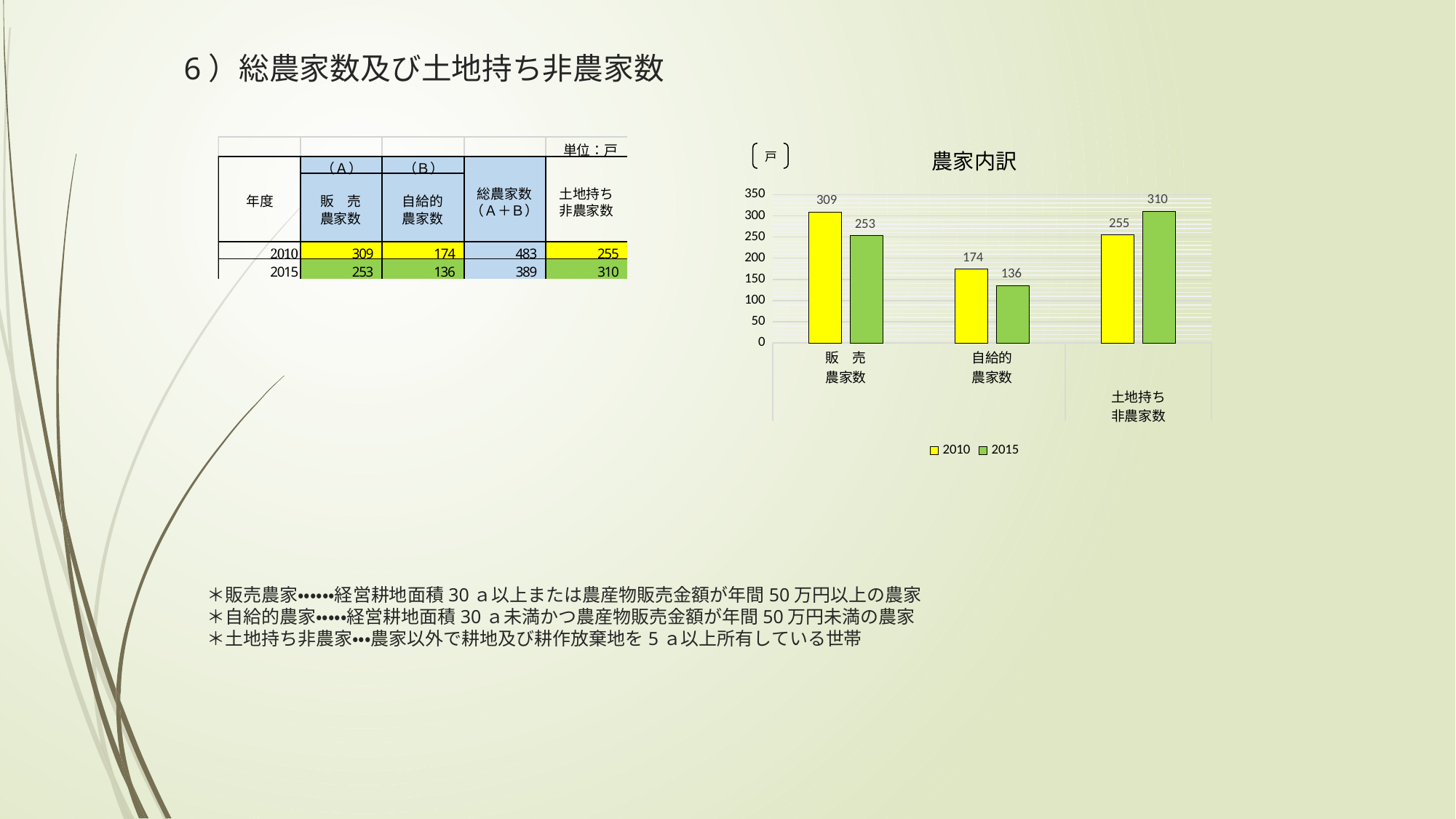
What is the title of the chart on the slide? 農家内訳 Which category has the lowest 2015 value in the 農家内訳 chart? 自給的農家数 How many series does the legend of the 農家内訳 chart list? 2 In the 農家内訳 chart, is the 2010 value for 土地持ち非農家数 larger or smaller than the 2015 value? smaller Which category has the highest 2010 value in the 農家内訳 chart? 販売農家数 What is the value for 自給的農家数 in 2015 in the 農家内訳 chart? 136 What kind of chart is the 農家内訳 chart? bar chart What is the value for 土地持ち非農家数 in 2015 in the 農家内訳 chart? 310 How many categories are shown on the x axis of the 農家内訳 chart? 3 What is the difference between the 2015 and 2010 values for 土地持ち非農家数 in the 農家内訳 chart? 55 What is the difference between the 2010 and 2015 values for 販売農家数 in the 農家内訳 chart? 56 What is the value for 販売農家数 in 2010 in the 農家内訳 chart? 309